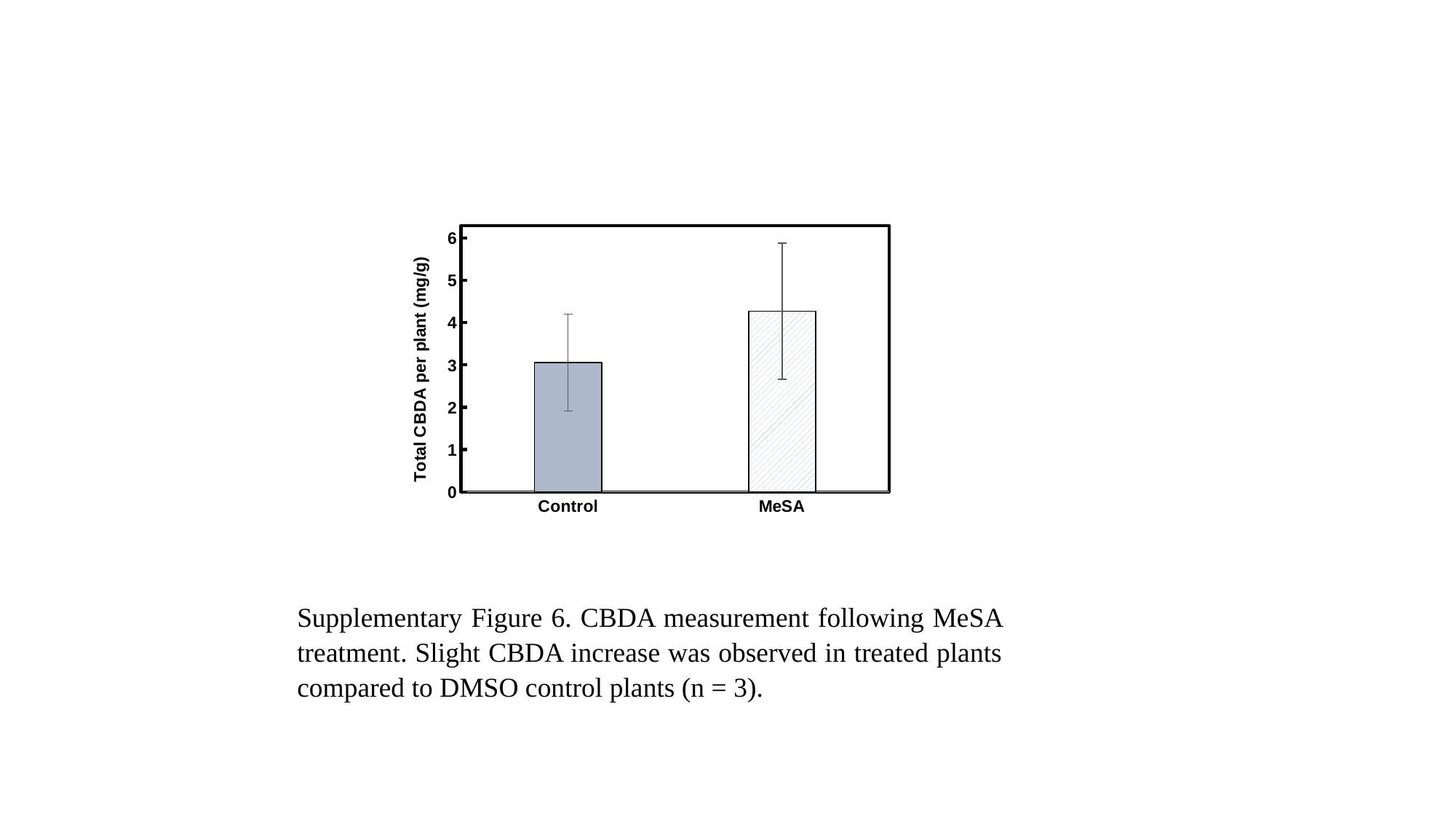
Is the value for MeSA greater or less than 4? greater Is the value for Control greater or less than 4? less Which category has the lowest Total CBDA per plant? Control How many categories are plotted on the x axis? 2 Which has a larger Total CBDA per plant, Control or MeSA? MeSA Is the value for Control greater or less than 2? greater Which category has the highest Total CBDA per plant? MeSA What is the maximum value shown on the y axis? 6 What is the label of the y axis? Total CBDA per plant (mg/g) What kind of chart is shown on the slide? bar chart